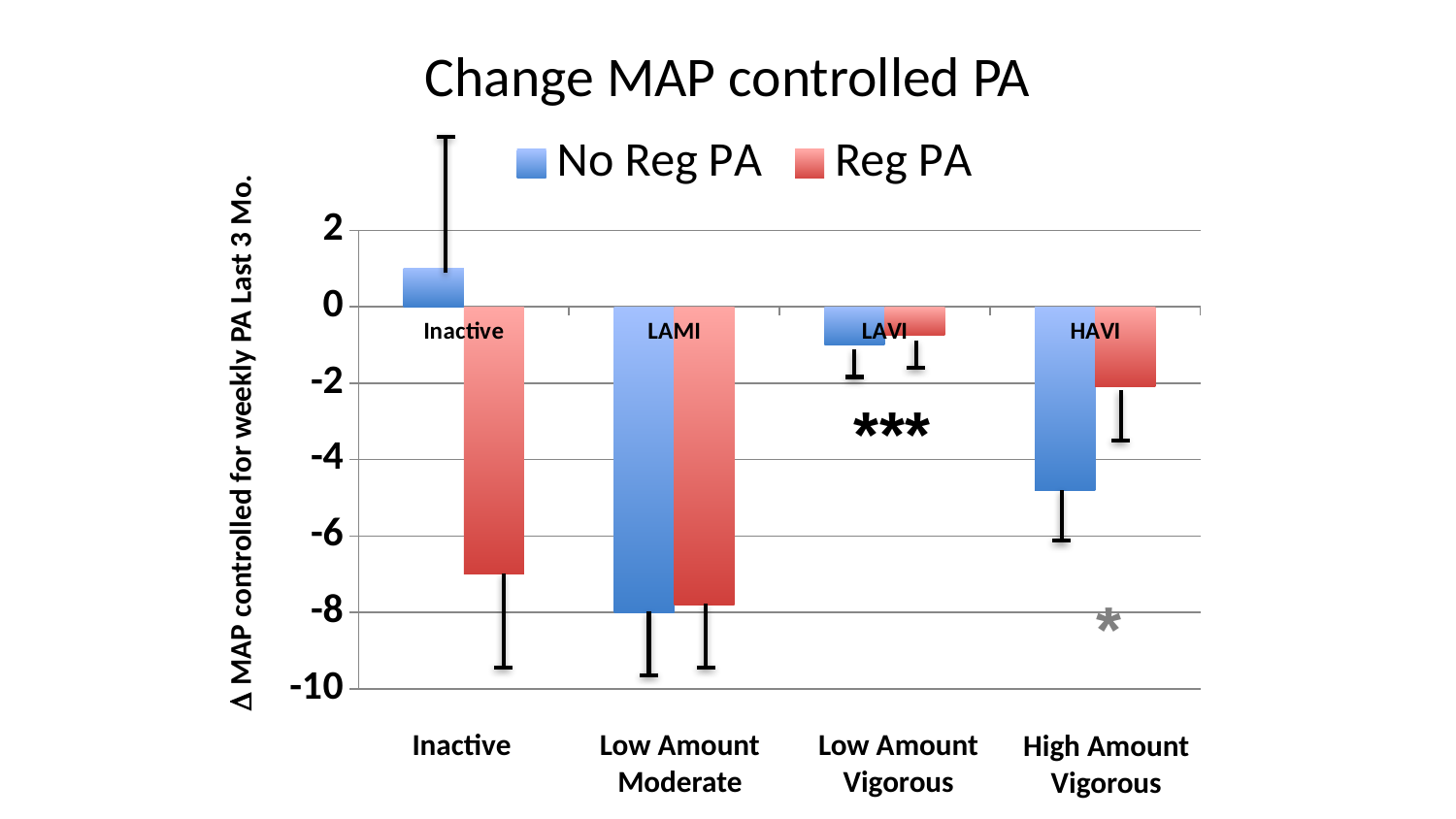
What kind of chart is shown on the slide? bar chart For the High Amount Vigorous category, which series has the larger value, No Reg PA or Reg PA? Reg PA Which colour represents the Reg PA series? red How many categories are shown on the x axis? 4 How many series does the legend list? 2 Is the Reg PA value for Inactive greater or less than -6? less Is the No Reg PA value for High Amount Vigorous greater or less than -4? less Which category has the highest value for the Reg PA series? Low Amount Vigorous What is the title of the chart? Change MAP controlled PA For the Inactive category, which series has the larger value, No Reg PA or Reg PA? No Reg PA Which category has the lowest value for the No Reg PA series? Low Amount Moderate Which category has the highest value for the No Reg PA series? Inactive